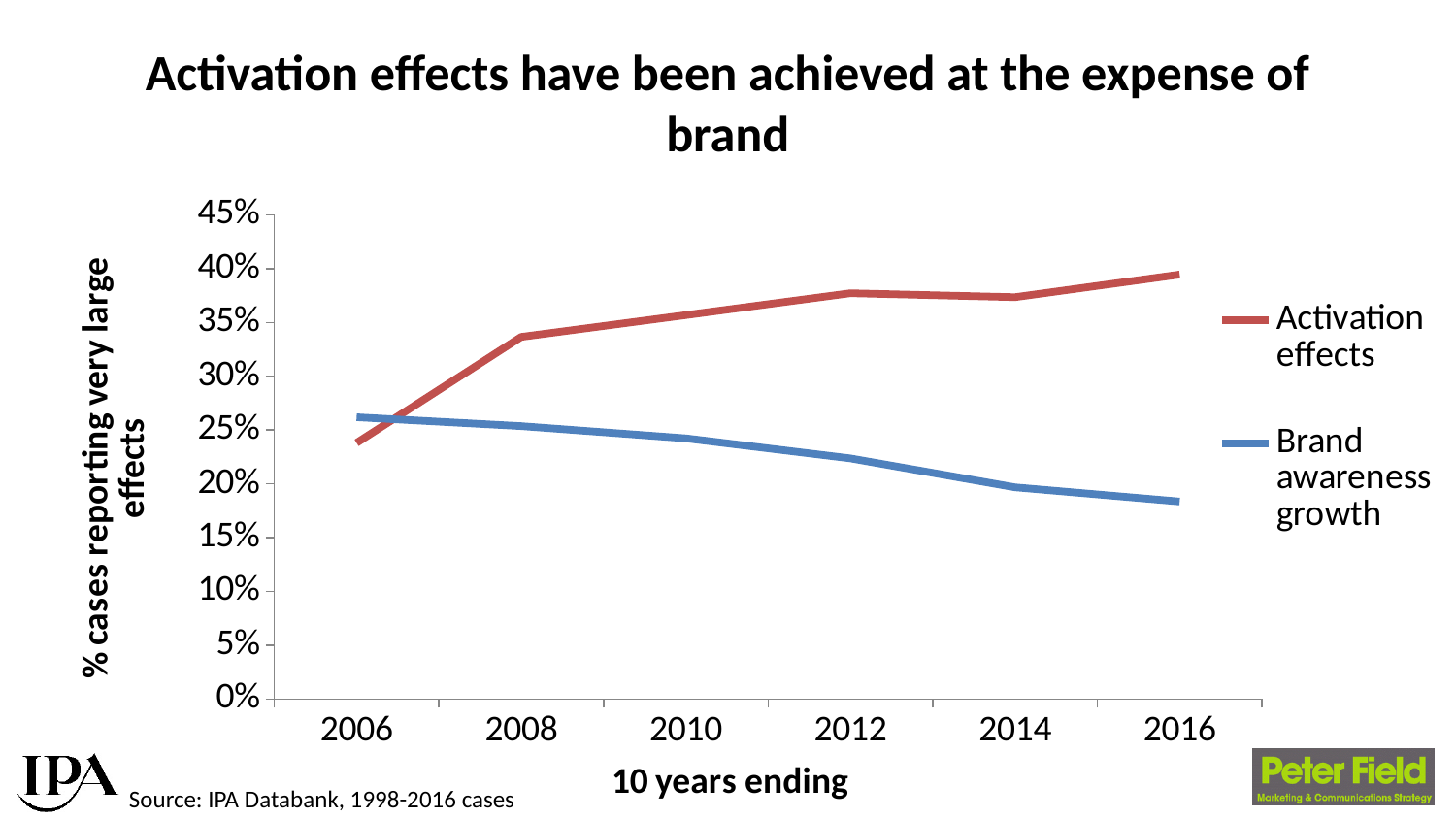
What kind of chart is shown on the slide? Line chart In which year does the Brand awareness growth line reach its lowest value? 2016 Is the value for Activation effects in 2016 greater or less than 35%? greater In 2012, which series has the higher value, Activation effects or Brand awareness growth? Activation effects Is the value for Activation effects in 2006 greater or less than 30%? less Does the Activation effects line rise or fall from 2006 to 2016? Rises Does the Brand awareness growth line rise or fall from 2006 to 2016? Falls In which year does the Activation effects line reach its highest value? 2016 What is the label on the x axis of the chart? 10 years ending How many series does the legend list? 2 How many years are marked along the x axis? 6 Is the value for Brand awareness growth in 2016 greater or less than 20%? less